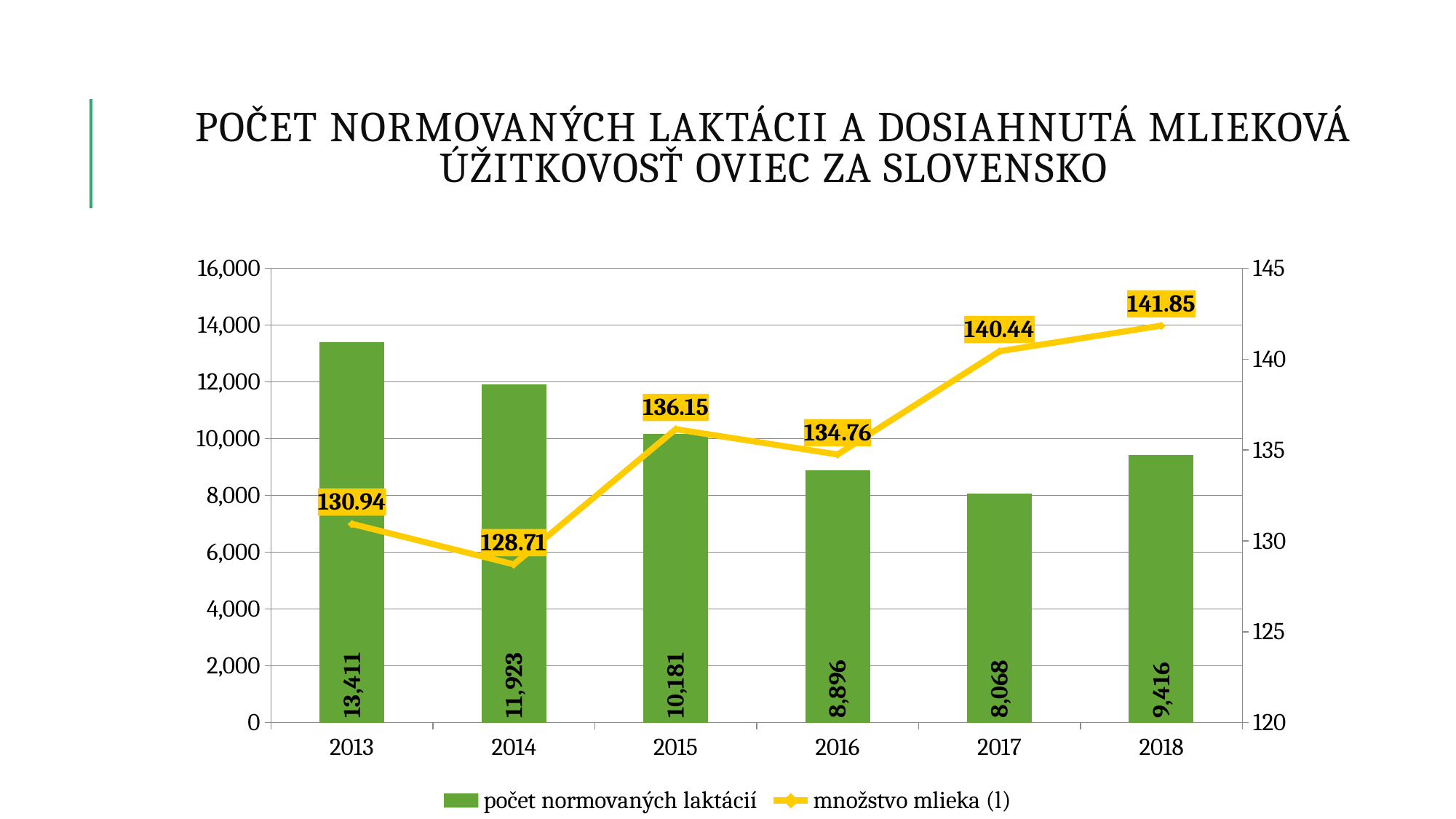
What is the difference in počet normovaných laktácií between 2013 and 2014? 1,488 What kind of chart is used for the počet normovaných laktácií series? bar chart Which year has the lowest počet normovaných laktácií? 2017 Is the počet normovaných laktácií for 2015 greater or less than 10,000? greater What is the množstvo mlieka (l) value for 2018? 141.85 Which is larger, the počet normovaných laktácií in 2016 or in 2018? 2018 Which year has the highest množstvo mlieka (l)? 2018 How many years are shown on the x axis? 6 How many series does the legend list? 2 Does the množstvo mlieka (l) series rise or fall from 2014 to 2018? rise What is the množstvo mlieka (l) value for 2014? 128.71 What is the value of počet normovaných laktácií for 2013? 13,411